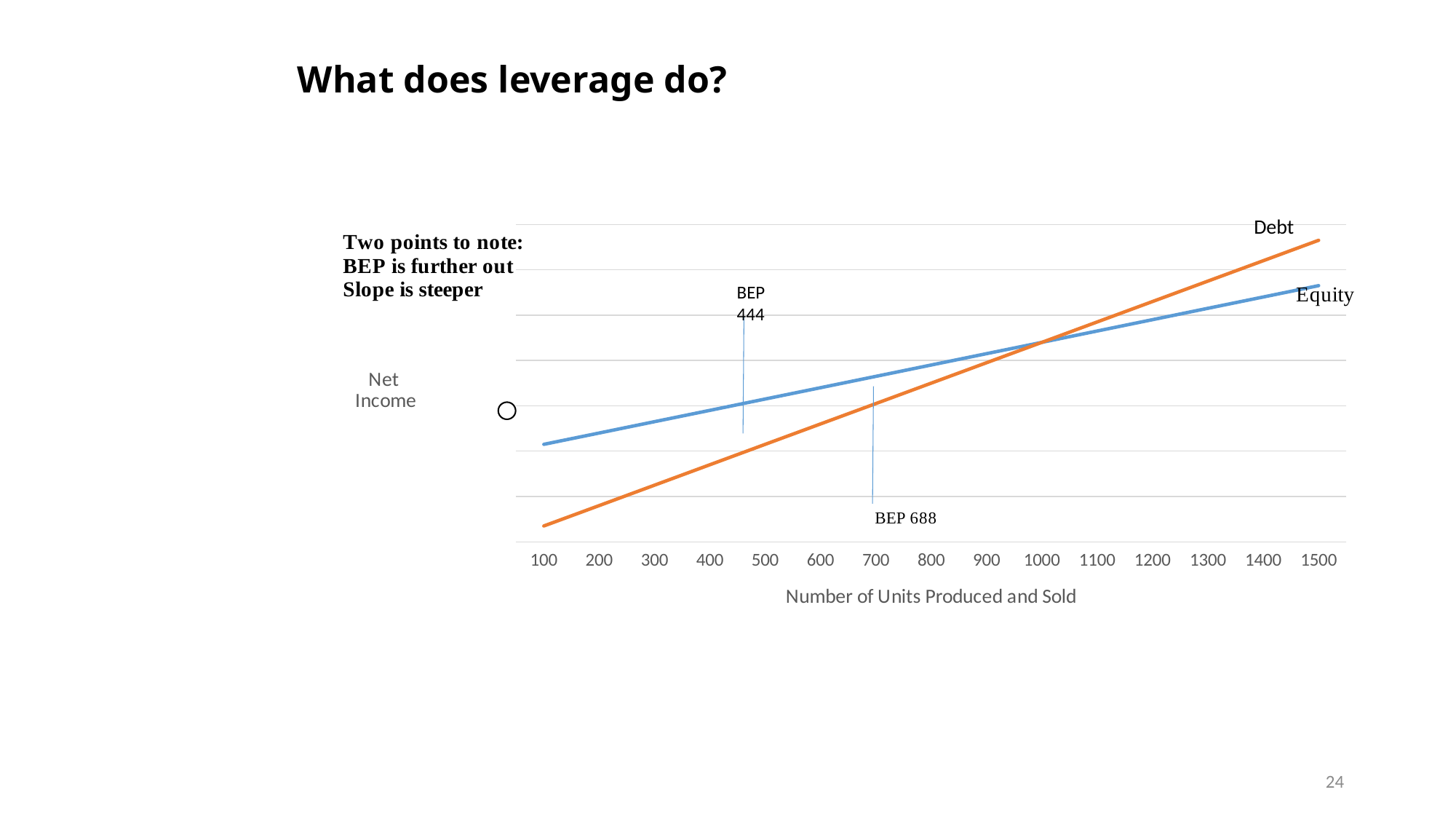
How many tick labels are shown on the x axis? 15 What break-even point (BEP) is annotated on the Debt line? 688 What kind of chart is shown on the slide? Line chart At 1500 units, which line shows the higher net income, Debt or Equity? Debt At 100 units, which line shows the higher net income, Debt or Equity? Equity How many lines (series) are plotted on the chart? 2 What is the difference between the two annotated break-even points, 688 and 444? 244 Which line is steeper, Debt or Equity? Debt What break-even point (BEP) is annotated on the Equity line? 444 What is the title of the x axis of the chart? Number of Units Produced and Sold What are the names of the two lines plotted on the chart? Debt and Equity Do the Debt and Equity lines rise or fall as the number of units increases? Rise